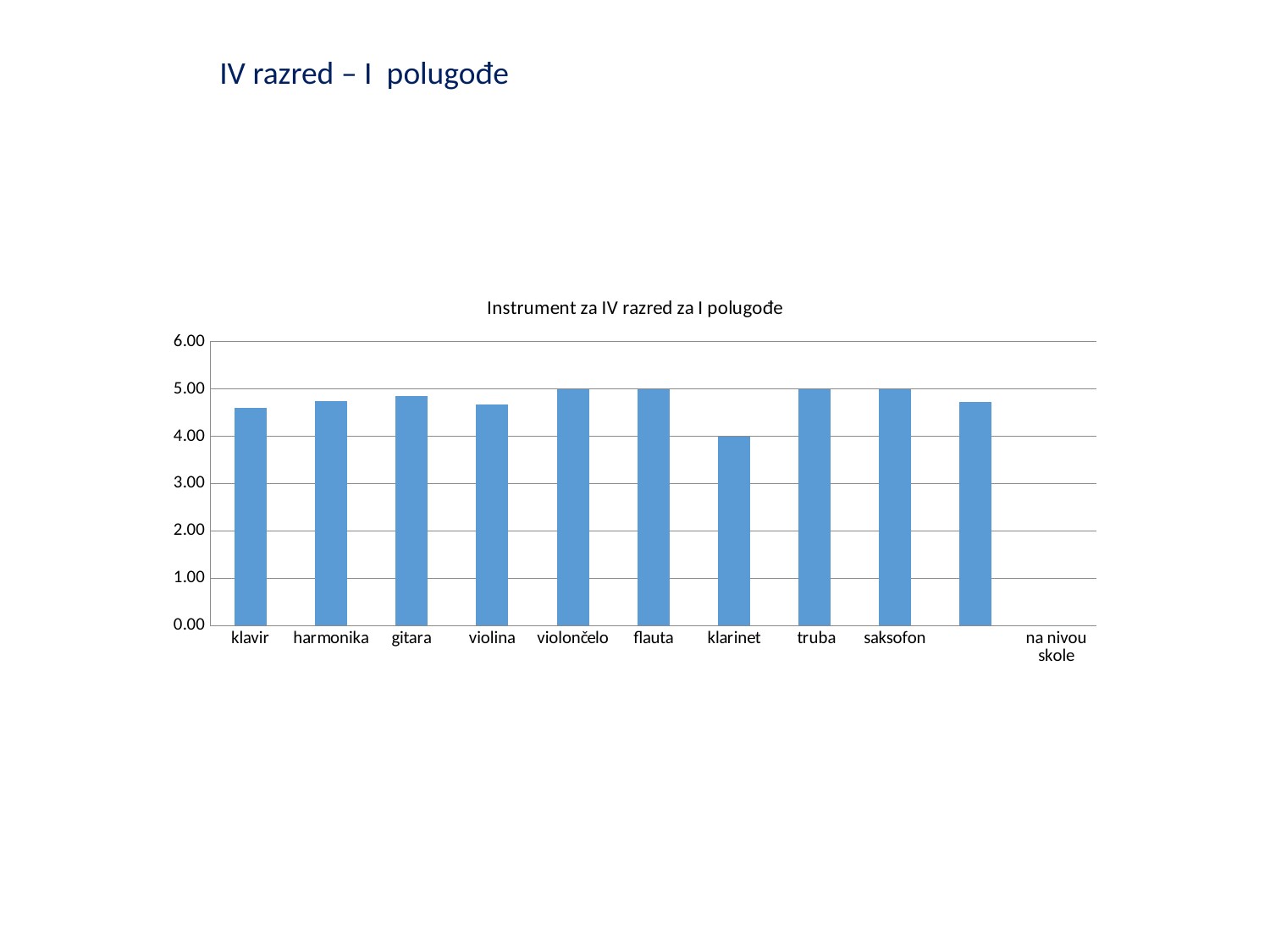
Which is larger, the value for klavir or the value for klarinet? klavir What colour are the bars in the chart? blue Is the value for gitara greater or less than 5.00? less What kind of chart is shown on the slide? bar chart What is the value for flauta? 5.00 What is the title of the chart? Instrument za IV razred za I polugođe Which is larger, the value for gitara or the value for klavir? gitara Is the value for harmonika greater or less than 4.00? greater What is the value for klarinet? 4.00 Is the value for klavir greater or less than 5.00? less Which is larger, the value for truba or the value for klarinet? truba